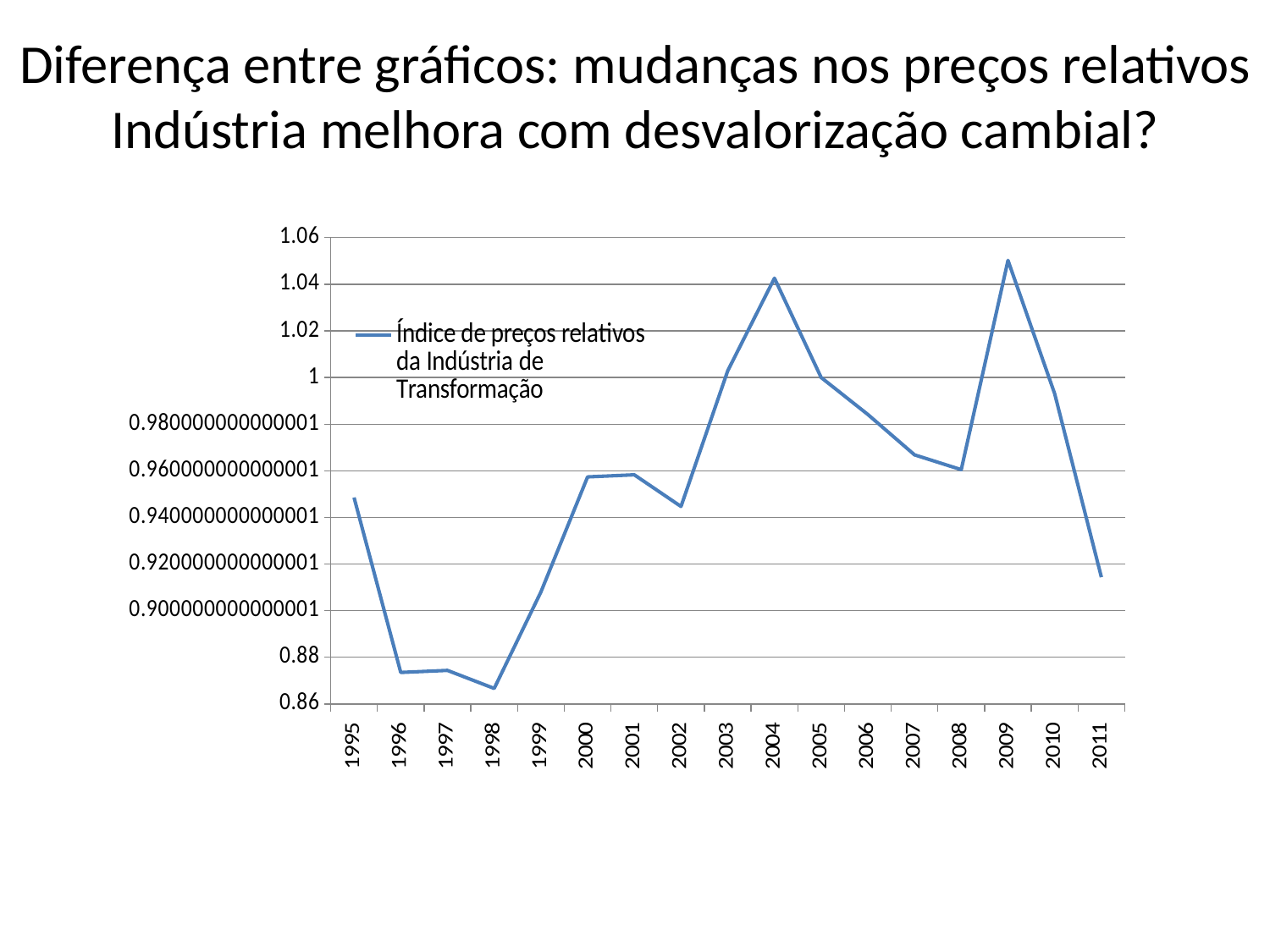
Does the index rise or fall between 1998 and 2004? rise In which year does the index reach its lowest value? 1998 What kind of chart is shown on the slide? line chart Is the value for 2004 greater or less than 1.02? greater Is the value for 2006 greater or less than 0.96? greater How many series does the legend list? 1 Is the value for 2011 greater or less than 0.94? less In which year does the index reach its highest value? 2009 Which year has the larger value, 2004 or 2002? 2004 How many years are plotted along the x axis? 17 What is the name of the series shown in the legend? Índice de preços relativos da Indústria de Transformação